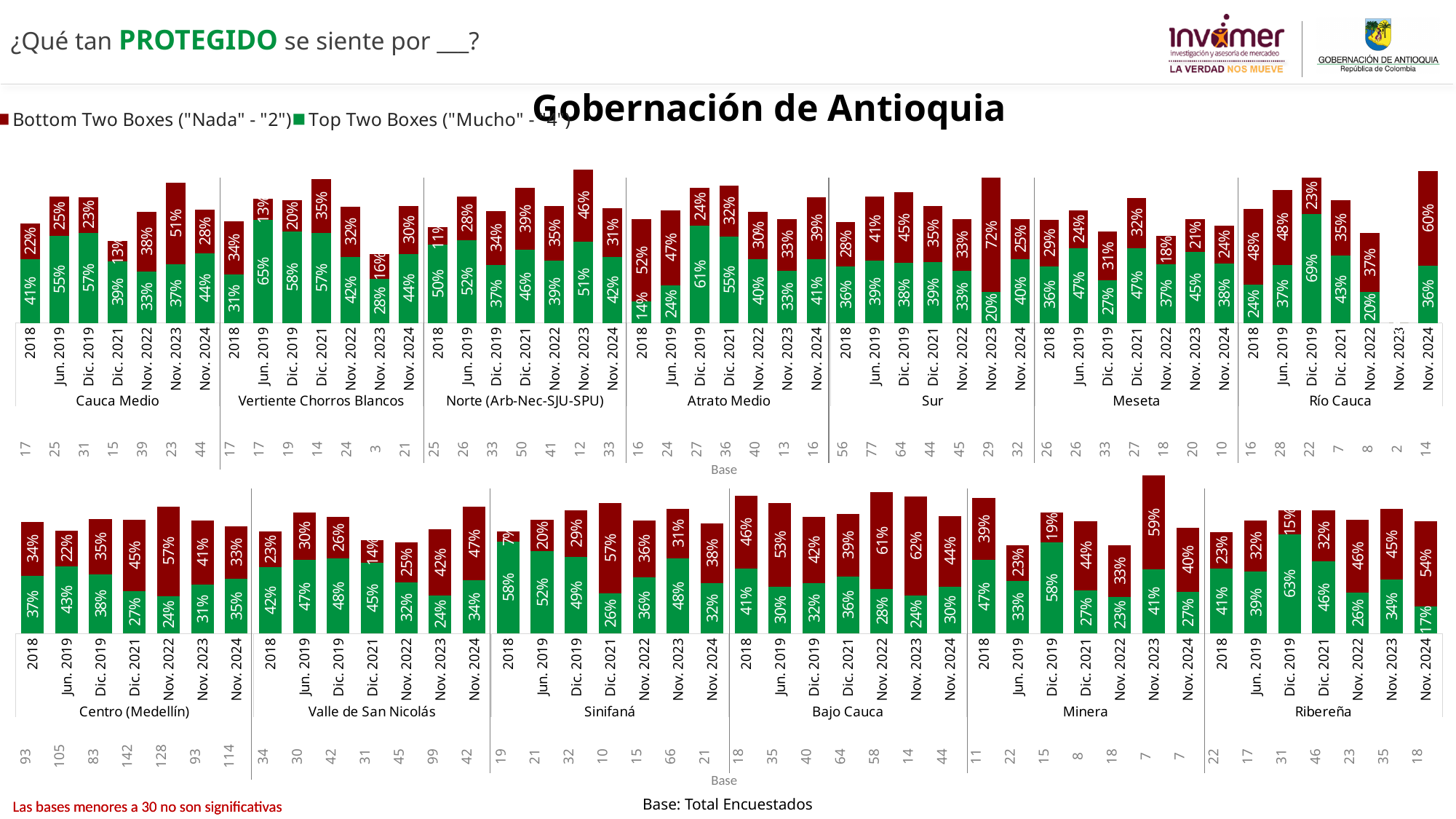
In the bottom chart, what is the total of the stacked bar for Centro (Medellín) in Nov. 2022? 81% In the top chart, what is the Top Two Boxes value for Cauca Medio in Nov. 2024? 44% In the bottom chart, how many regions are shown along the x axis? 6 In the top chart, what is the Bottom Two Boxes value for Sur in Nov. 2023? 72% In the bottom chart, which period has the lowest Bottom Two Boxes value for Sinifaná? 2018 In the top chart, what colour represents the Top Two Boxes series? Green In the top chart, which period has the highest Top Two Boxes value for Río Cauca? Dic. 2019 In the bottom chart, what is the Top Two Boxes value for Ribereña in Dic. 2019? 63% What kind of chart is shown on the slide? Stacked bar chart In the bottom chart, which is larger for Bajo Cauca in Nov. 2023: the Top Two Boxes value or the Bottom Two Boxes value? Bottom Two Boxes In the top chart, what is the difference between the Bottom Two Boxes and Top Two Boxes values for Atrato Medio in 2018? 38% How many series does the legend list? 2